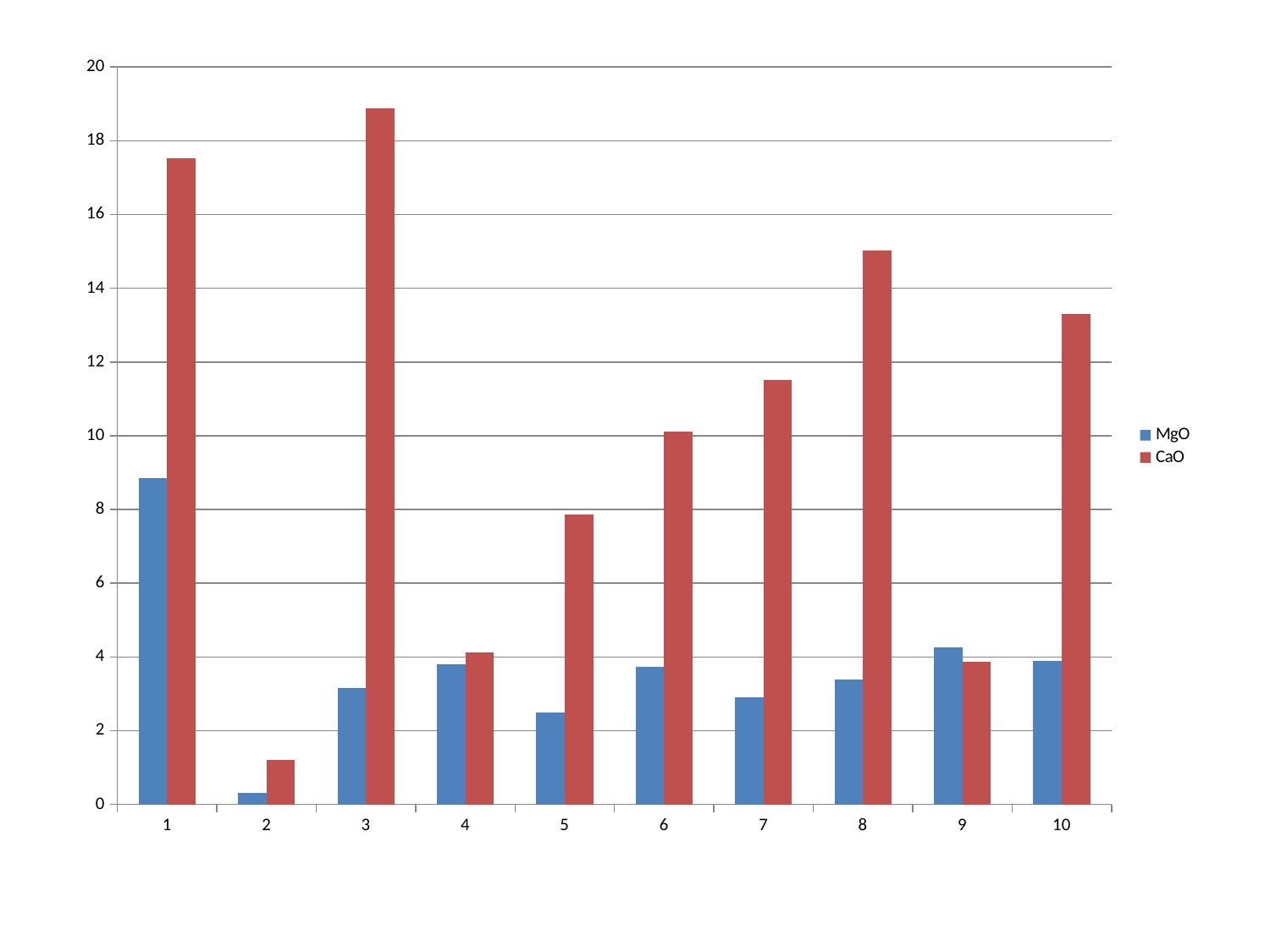
Which category has the lowest MgO value? 2 Which category has the lowest CaO value? 2 Is the CaO value for category 10 greater or less than 12? greater What kind of chart is shown on the slide? bar chart Which series is shown in red? CaO How many categories are shown on the x axis? 10 Which category has the highest MgO value? 1 Which is larger, the CaO value for category 1 or the CaO value for category 8? category 1 How many series does the legend list? 2 Which category has the highest CaO value? 3 Is the MgO value for category 1 greater or less than 8? greater Is the CaO value for category 3 greater or less than 18? greater